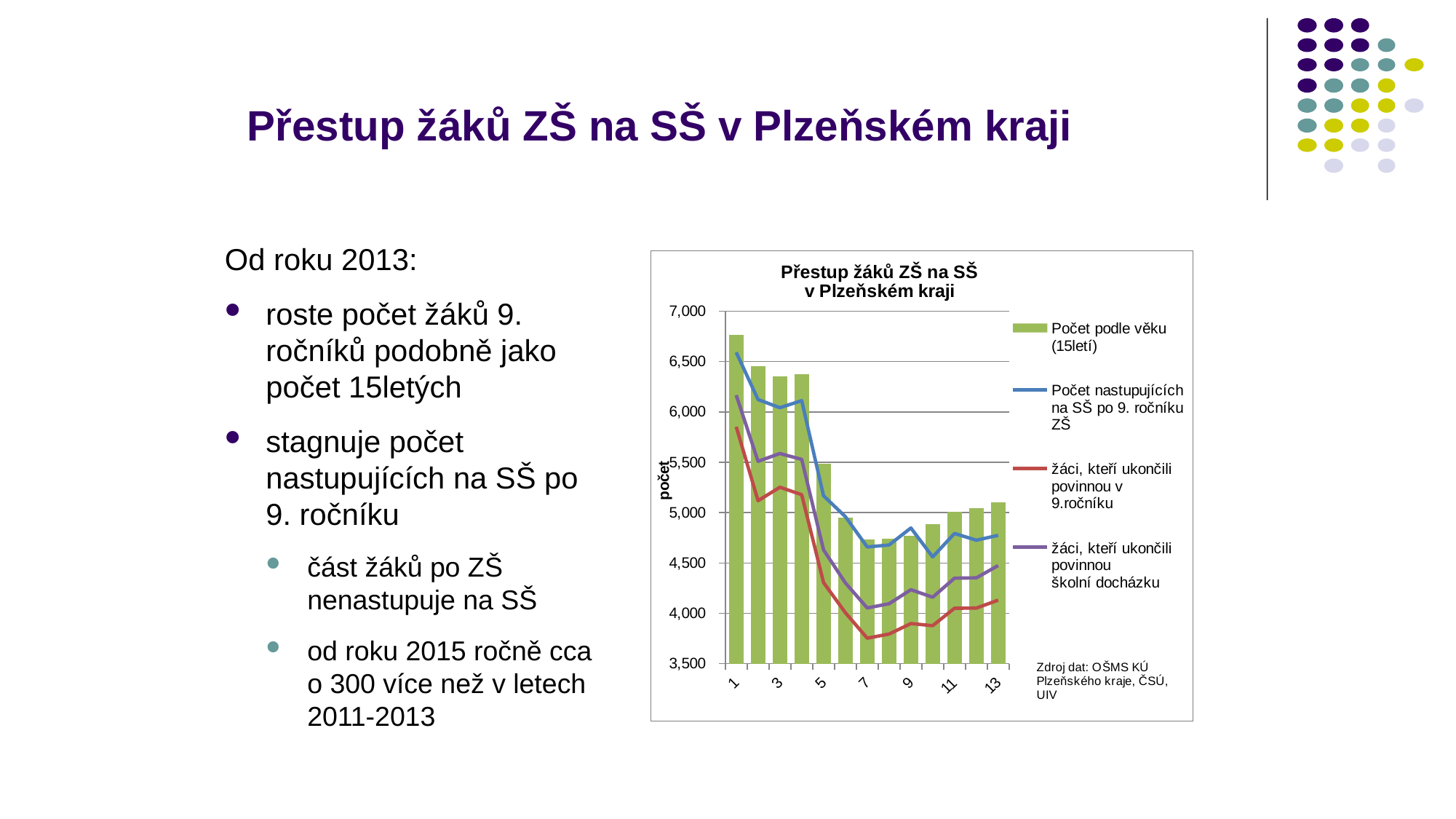
Which is larger: the bar for category 1 or the bar for category 13? Category 1 Which category has the highest bar for 'Počet podle věku (15letí)'? 1 Is the value of the 'Počet nastupujících na SŠ po 9. ročníku ZŠ' line at category 1 greater or less than 6,500? greater What is the title of the chart? Přestup žáků ZŠ na SŠ v Plzeňském kraji Is the bar value for category 1 ('Počet podle věku (15letí)') greater or less than 6,500? greater Is the bar value for category 7 ('Počet podle věku (15letí)') greater or less than 5,000? less Which line series has the lowest values across the chart? žáci, kteří ukončili povinnou v 9.ročníku Do the values of the 'Počet nastupujících na SŠ po 9. ročníku ZŠ' line rise or fall from category 1 to category 7? Fall What kind of chart is shown on the slide? Combined bar and line chart How many categories are shown along the x axis of the chart? 13 How many series does the chart legend list? 4